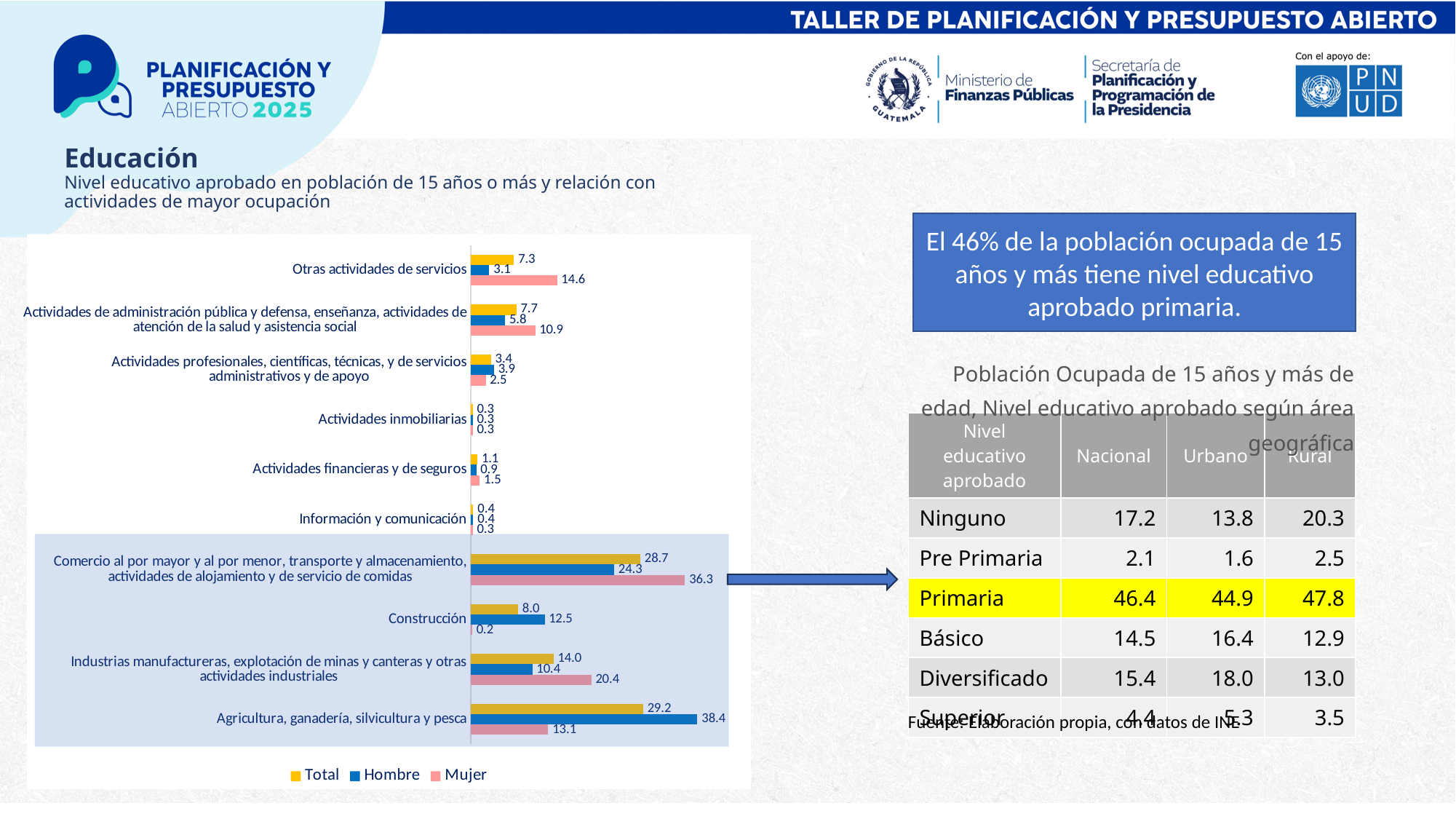
Which series in the legend is shown in pink? Mujer How many activity categories are plotted in the chart? 10 What type of chart is shown on the slide? bar chart Which category has the lowest Mujer value? Construcción Which category has the highest Hombre value? Agricultura, ganadería, silvicultura y pesca What is the Total value for Construcción? 8.0 Which is larger for Industrias manufactureras, explotación de minas y canteras y otras actividades industriales: the Hombre value or the Mujer value? Mujer How many series does the chart legend list? 3 What is the Mujer value for Comercio al por mayor y al por menor, transporte y almacenamiento, actividades de alojamiento y de servicio de comidas? 36.3 What is the difference between the Total values for Agricultura, ganadería, silvicultura y pesca and Comercio al por mayor y al por menor, transporte y almacenamiento, actividades de alojamiento y de servicio de comidas? 0.5 What is the Hombre value for Agricultura, ganadería, silvicultura y pesca? 38.4 What is the difference between the Mujer and Hombre values for Otras actividades de servicios? 11.5